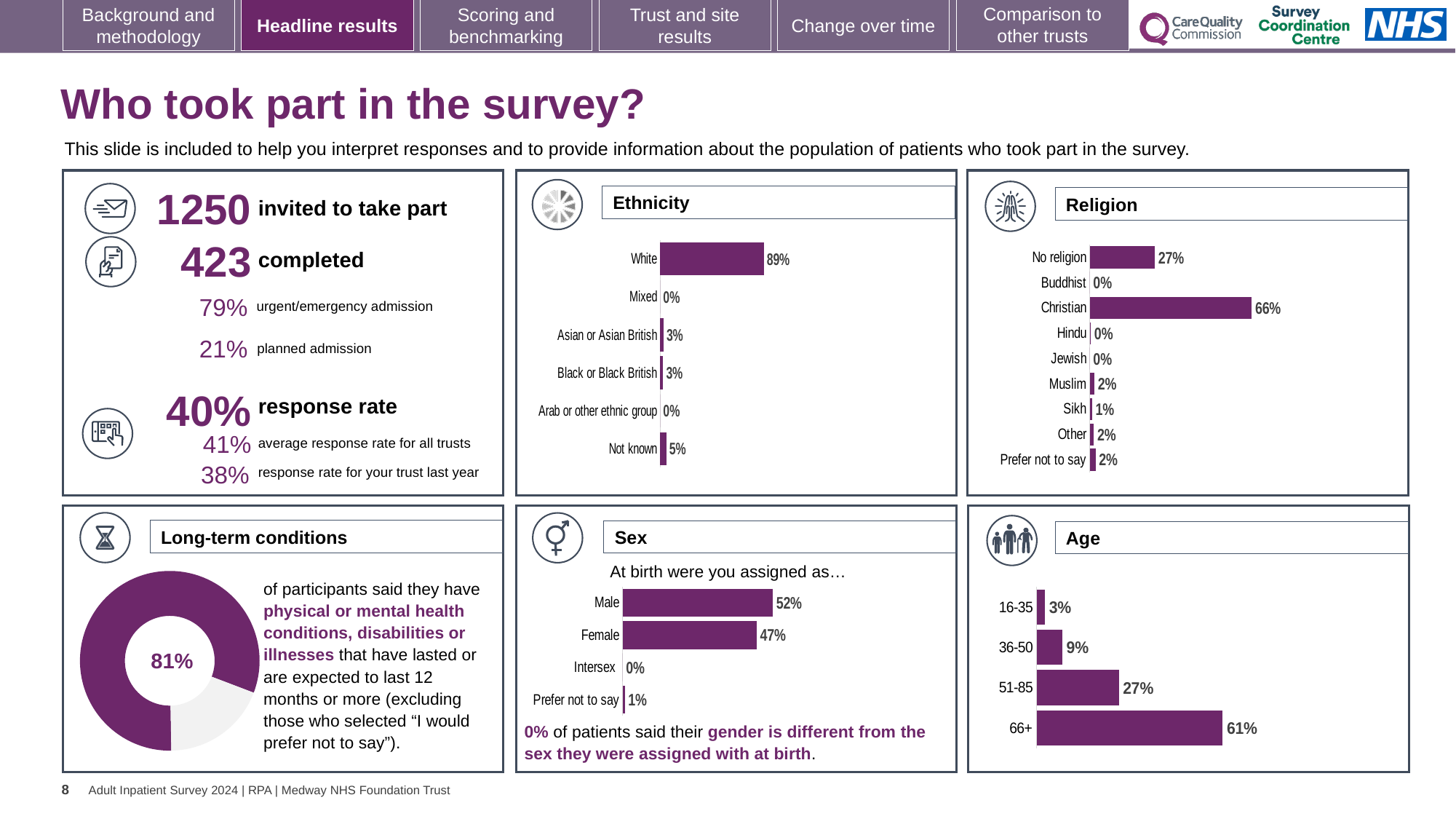
In the Age chart, what is the value for 36-50? 9% In the Age chart, do the values rise or fall as the age groups increase? rise In the Sex chart, what is the difference between Male and Female? 5% In the Age chart, which age group has the highest value? 66+ In the Sex chart, which is larger, Male or Female? Male What kind of chart is the Long-term conditions chart? doughnut chart In the Religion chart, which category has the highest value? Christian In the Ethnicity chart, what is the value for Not known? 5% In the Religion chart, how many categories are shown? 9 In the Ethnicity chart, what percentage of respondents are White? 89% In the Religion chart, what is the value for No religion? 27% In the Religion chart, what is the difference between Christian and No religion? 39%